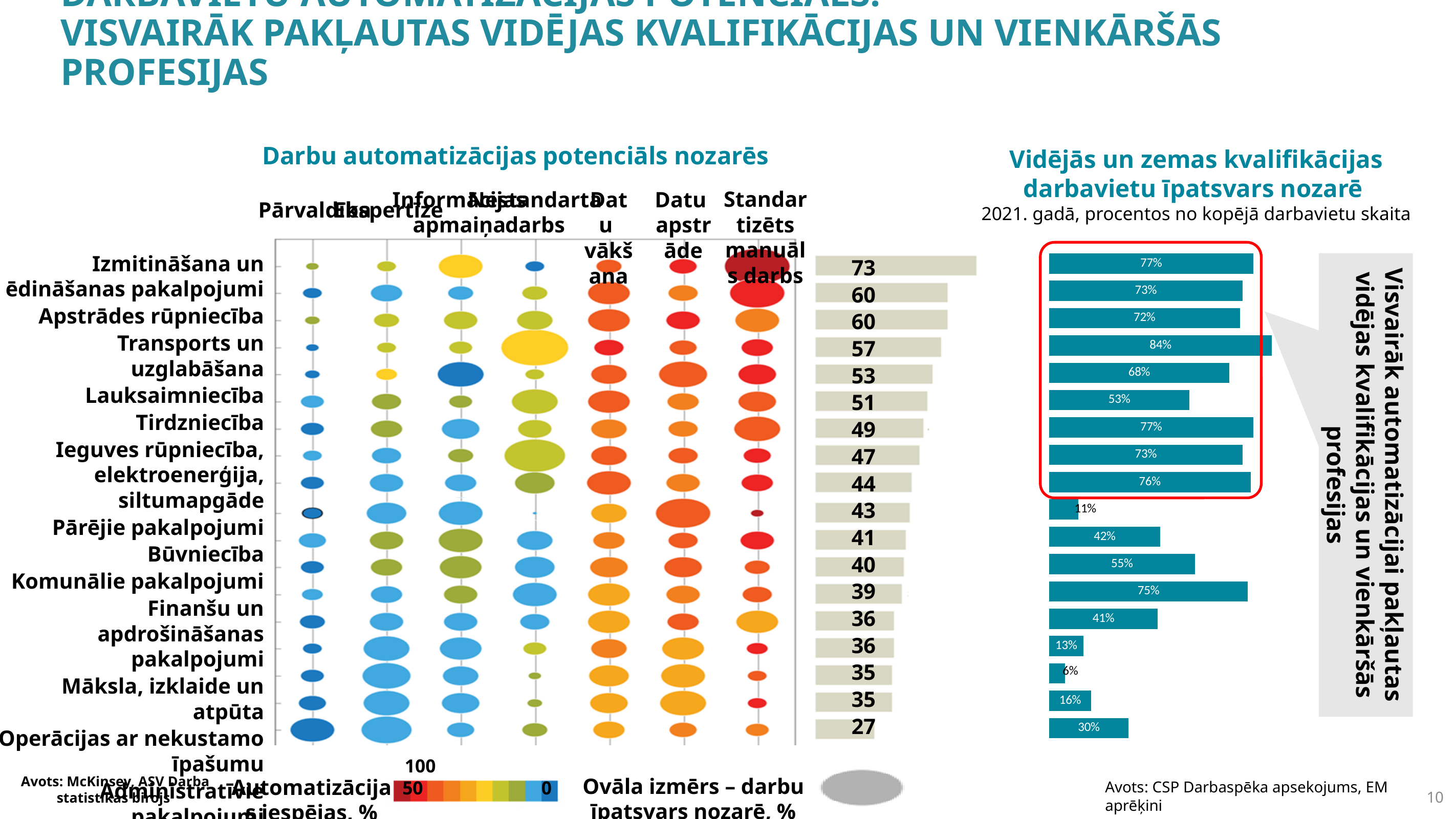
On the left chart 'Darbu automatizācijas potenciāls nozarēs', what is the highest automation potential value listed in the number column? 73 On the right chart 'Vidējās un zemas kvalifikācijas darbavietu īpatsvars nozarē', what is the difference between the highest value (84%) and the lowest value (6%)? 78 percentage points On the right chart 'Vidējās un zemas kvalifikācijas darbavietu īpatsvars nozarē', what is the value of the bottom bar? 30% On the right chart 'Vidējās un zemas kvalifikācijas darbavietu īpatsvars nozarē', how many bars are plotted? 18 On the left chart 'Darbu automatizācijas potenciāls nozarēs', what is the lowest automation potential value listed in the number column? 27 What kind of chart is the right chart 'Vidējās un zemas kvalifikācijas darbavietu īpatsvars nozarē'? Bar chart On the right chart 'Vidējās un zemas kvalifikācijas darbavietu īpatsvars nozarē', how many bars are enclosed in the red box? 9 On the right chart 'Vidējās un zemas kvalifikācijas darbavietu īpatsvars nozarē', what is the value of the topmost bar? 77% On the right chart 'Vidējās un zemas kvalifikācijas darbavietu īpatsvars nozarē', what is the lowest value shown? 6% On the right chart 'Vidējās un zemas kvalifikācijas darbavietu īpatsvars nozarē', what is the highest value shown? 84% On the left chart 'Darbu automatizācijas potenciāls nozarēs', what is the difference between the top value (73) and the bottom value (27)? 46 On the left chart 'Darbu automatizācijas potenciāls nozarēs', do the values in the number column rise or fall from top to bottom? Fall